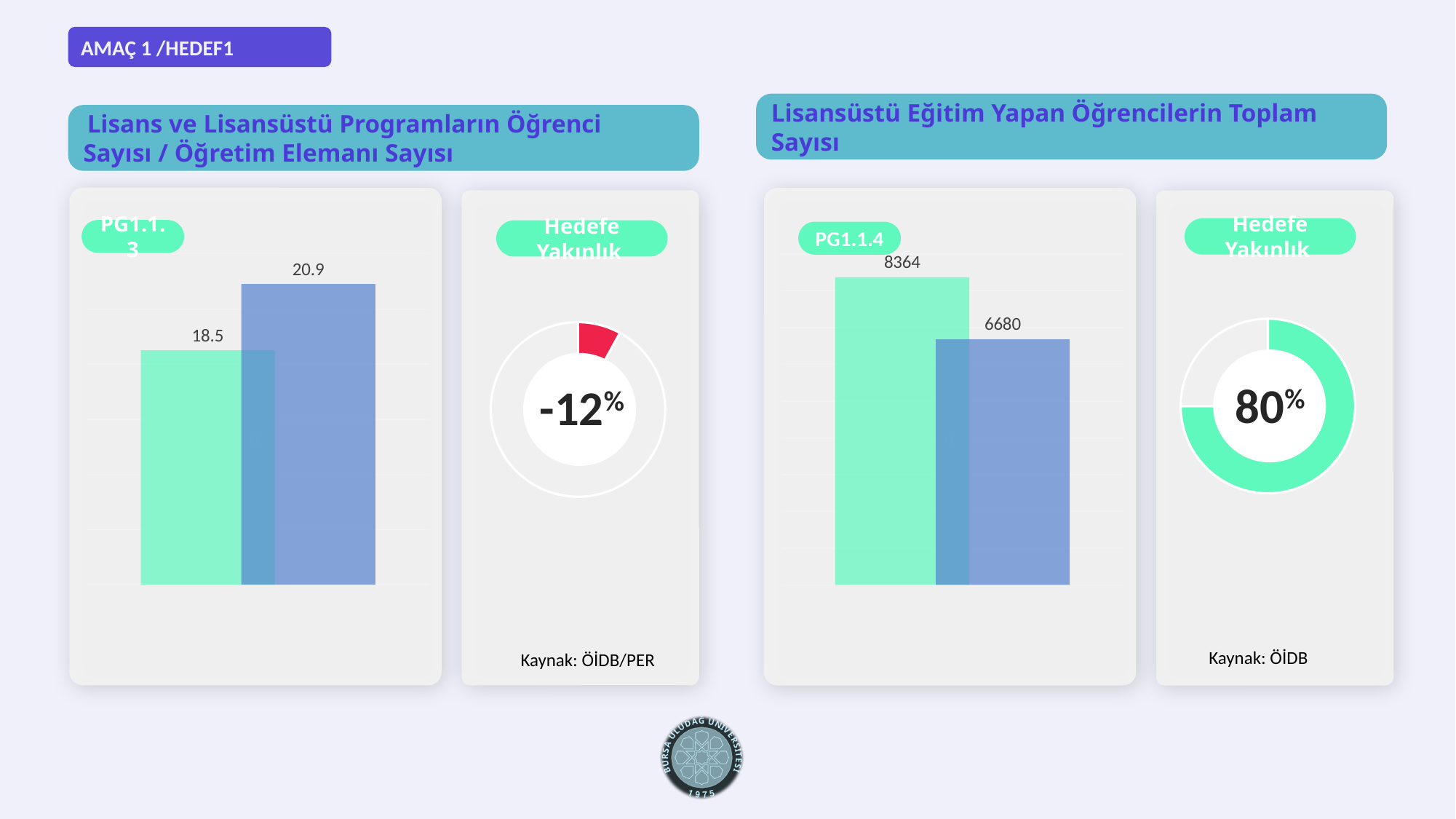
In the PG1.1.4 bar chart on the right, what value is shown on the blue bar? 6680 How many bars are plotted in the PG1.1.3 chart on the left? 2 What percentage is shown in the 'Hedefe Yakınlık' donut chart next to the PG1.1.3 chart? -12% In the PG1.1.3 bar chart on the left, what is the difference between the blue bar (20.9) and the green bar (18.5)? 2.4 What percentage is shown in the 'Hedefe Yakınlık' donut chart next to the PG1.1.4 chart? 80% In the PG1.1.3 bar chart on the left, what value is shown on the green bar? 18.5 In the PG1.1.3 bar chart on the left, which bar is taller, the green one or the blue one? the blue one In the PG1.1.4 bar chart on the right, what is the difference between the green bar (8364) and the blue bar (6680)? 1684 In the PG1.1.3 bar chart on the left, what value is shown on the blue bar? 20.9 In the PG1.1.4 bar chart on the right, what value is shown on the green bar? 8364 What kind of chart is the PG1.1.4 chart on the right? bar chart In the PG1.1.4 bar chart on the right, which bar is taller, the green one or the blue one? the green one